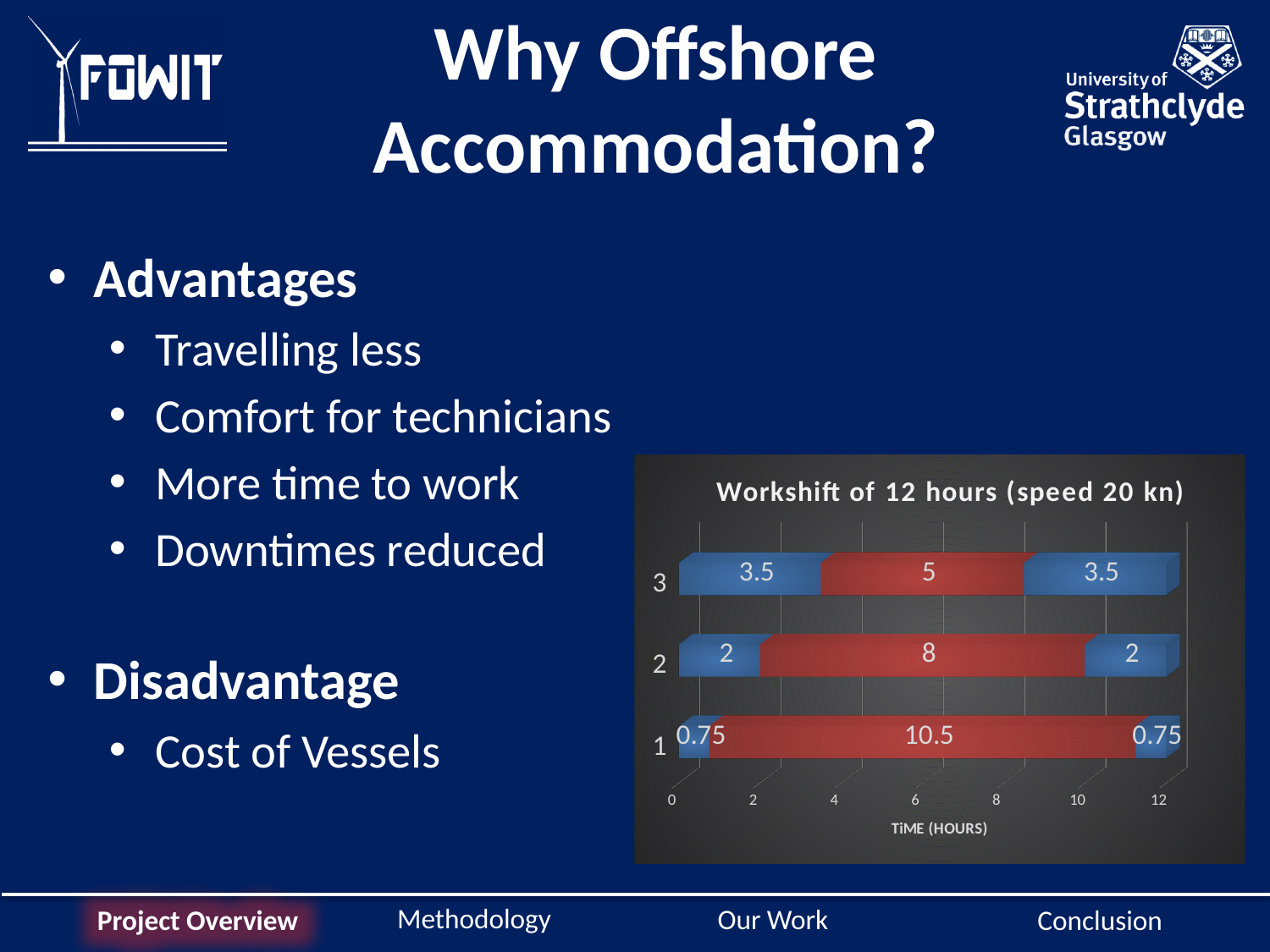
What is the label of the horizontal axis of the chart? TIME (HOURS) How many bars (categories) does the chart show? 3 What kind of chart is shown on the slide? stacked bar chart What is the value of the red (middle) segment for category 1? 10.5 Which category has the largest red (middle) segment? 1 What is the title of the chart? Workshift of 12 hours (speed 20 kn) What is the value of the first blue segment for category 3? 3.5 Which category has the smallest red (middle) segment? 3 What is the value of the red (middle) segment for category 2? 8 What is the difference between the red segment of category 1 and the red segment of category 3? 5.5 Is the red segment for category 2 larger or smaller than the red segment for category 3? larger What is the total of the stacked bar for category 2? 12